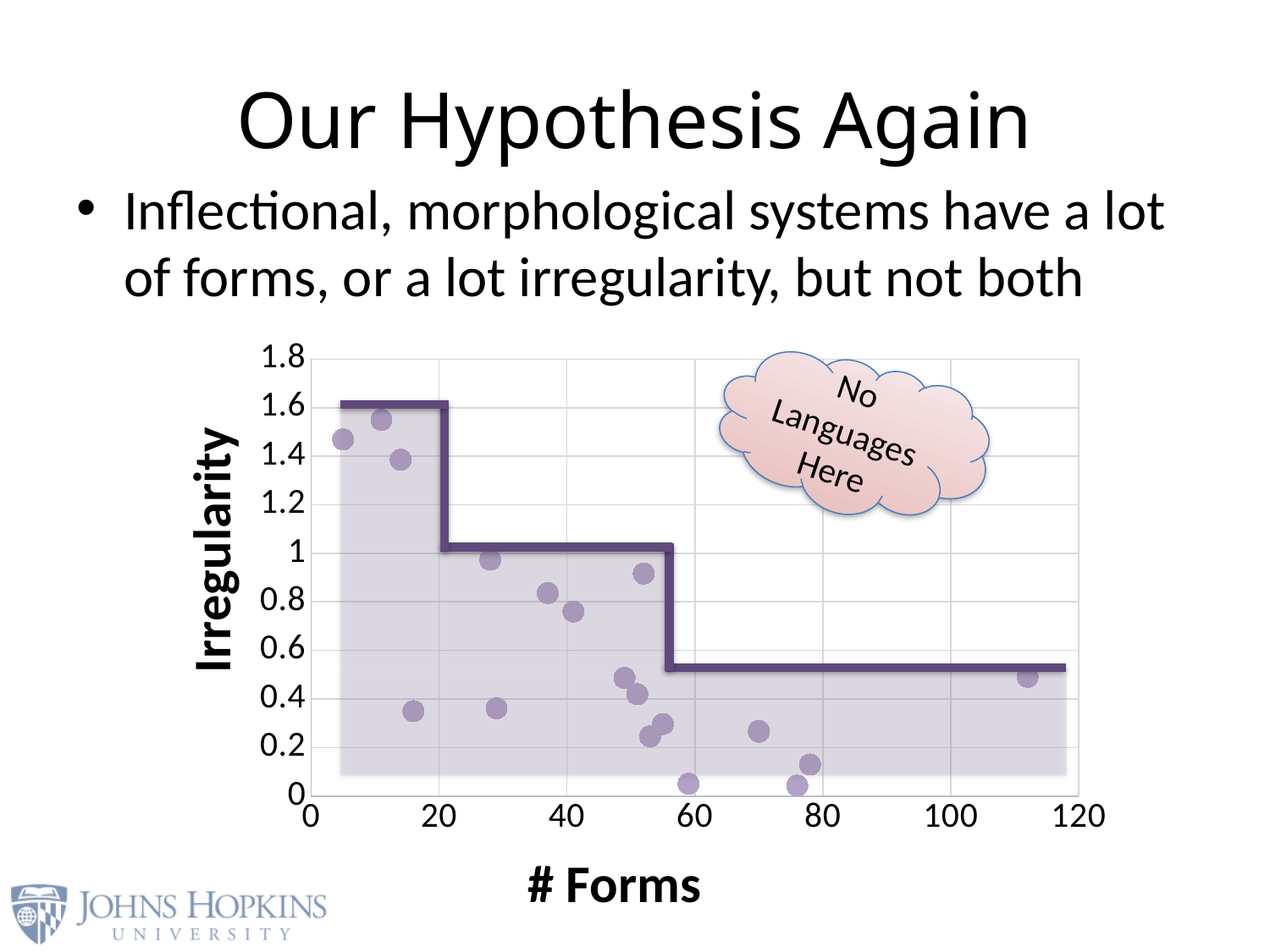
What is the highest tick value shown on the x axis? 120 What is the title of the x axis of the chart? # Forms What kind of chart is shown on the slide? scatter chart Is the irregularity of the highest point on the chart greater or less than 1.4? greater Do any points on the chart have an irregularity greater than 1.6? No As the number of forms increases along the x axis, does irregularity generally rise or fall? fall Is the irregularity of the point with the most forms (near 112 forms) greater or less than 0.6? less What is the title of the y axis of the chart? Irregularity What is the highest tick value shown on the y axis? 1.8